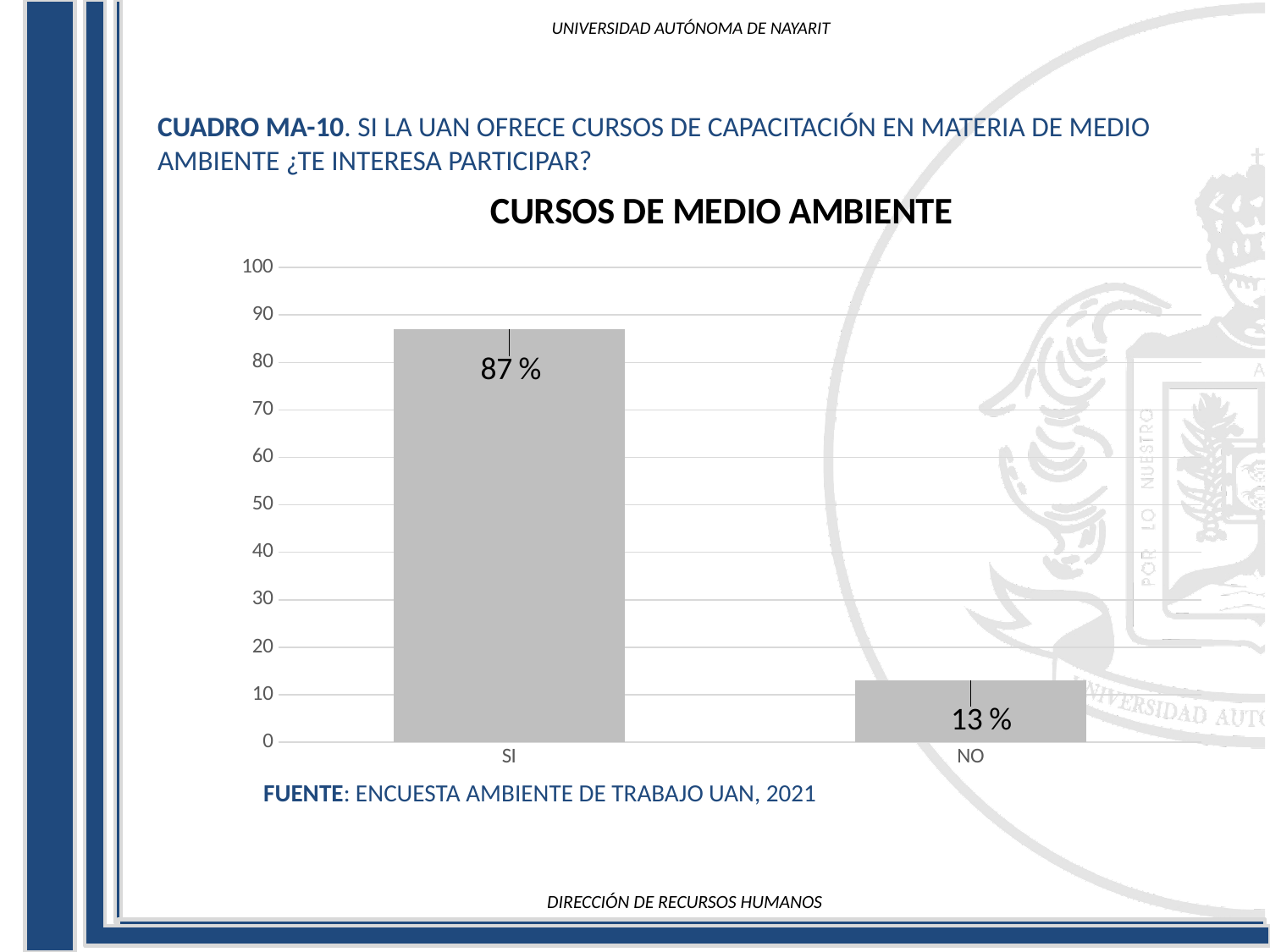
What is the maximum value shown on the vertical axis? 100 Is the value for SI greater or less than 80? greater What is the value for SI? 87 % What kind of chart is shown on the slide? bar chart What is the difference between the values for SI and NO? 74 % Is the value for NO greater or less than 20? less What is the value for NO? 13 % What is the title of the chart? CURSOS DE MEDIO AMBIENTE How many categories are shown in the chart? 2 Which category has the highest value? SI Which is larger, the value for SI or the value for NO? SI Which category has the lowest value? NO